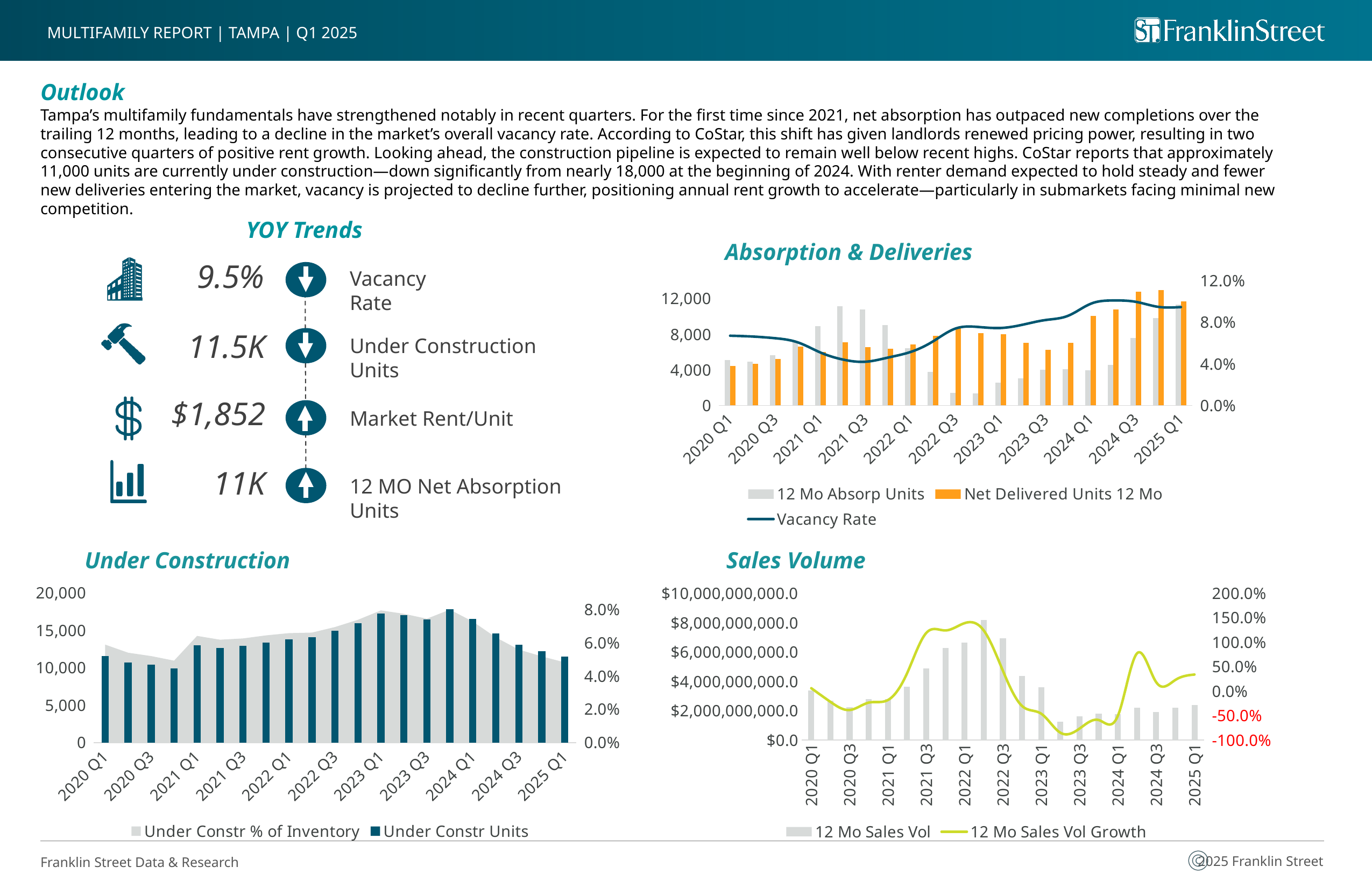
What kind of chart is the Sales Volume chart? bar and line chart In the Sales Volume chart, is the 12 Mo Sales Vol Growth for 2023 Q2 greater or less than 0.0%? less In the Absorption & Deliveries chart, how many series does the legend list? 3 In the Absorption & Deliveries chart, which quarter has the highest Net Delivered Units 12 Mo? 2024 Q4 In the Absorption & Deliveries chart, is the Vacancy Rate for 2021 Q3 greater or less than 8.0%? less In the Sales Volume chart, which quarter has the highest 12 Mo Sales Vol? 2022 Q2 In the Absorption & Deliveries chart, does the Vacancy Rate rise or fall from 2021 Q3 to 2024 Q3? rise In the Under Construction chart, how many quarters are plotted on the x axis from 2020 Q1 to 2025 Q1? 21 In the Under Construction chart, do the Under Constr Units rise or fall from 2023 Q4 to 2025 Q1? fall In the Under Construction chart, how many series does the legend list? 2 In the Under Construction chart, is the Under Constr Units value for 2025 Q1 greater or less than 10,000? greater In the Absorption & Deliveries chart, at 2022 Q3, which is larger: 12 Mo Absorp Units or Net Delivered Units 12 Mo? Net Delivered Units 12 Mo